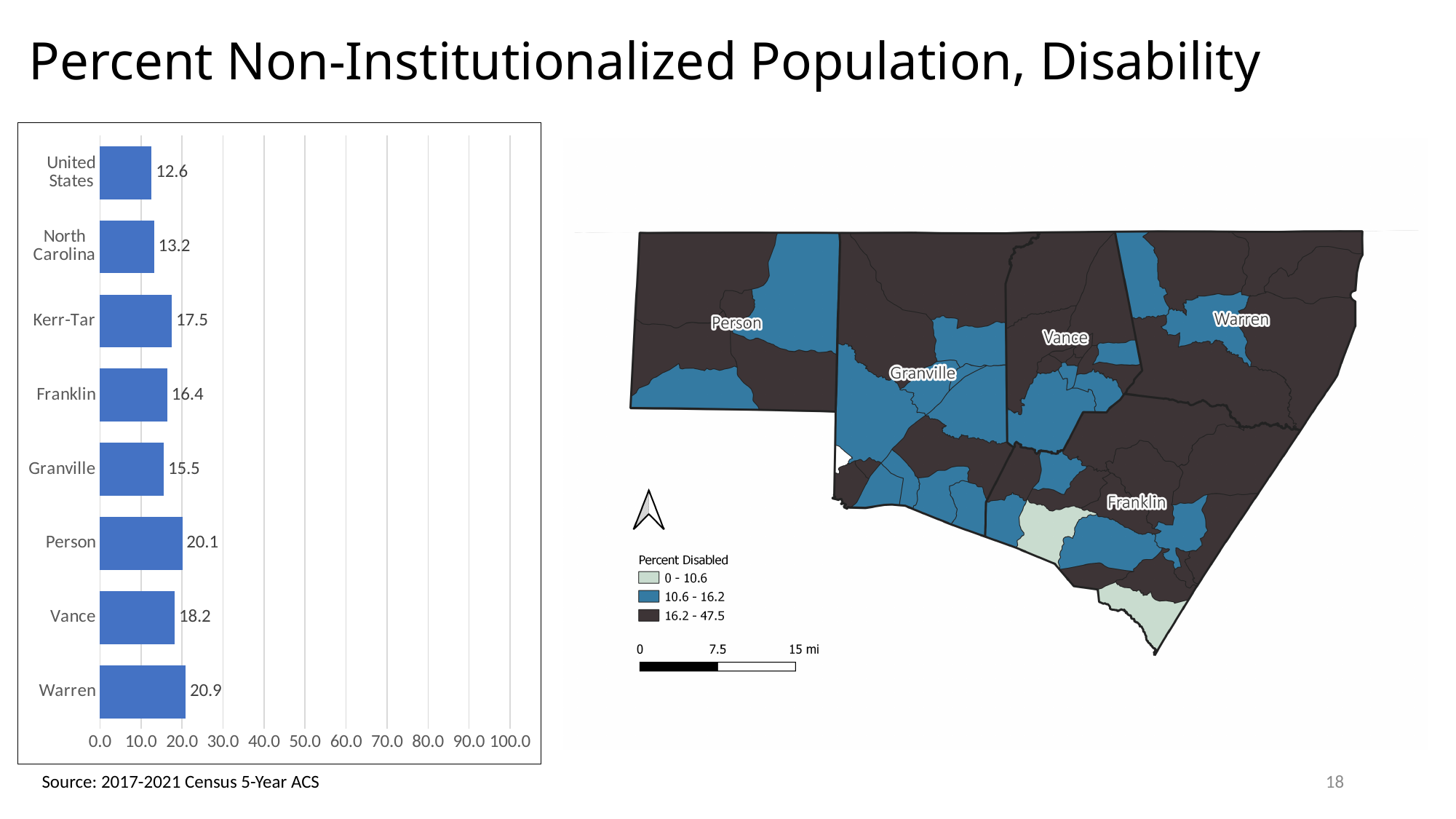
What is the value for Warren in the bar chart? 20.9 Which has a larger value in the bar chart, Vance or Franklin? Vance Is the value for Person in the bar chart greater or less than 30.0? less What is the difference between the values for Warren and United States in the bar chart? 8.3 What is the value for North Carolina in the bar chart? 13.2 What is the difference between the values for Person and Granville in the bar chart? 4.6 Which category has the highest value in the bar chart? Warren What kind of chart is shown on the left of the slide? bar chart What is the highest value on the x axis of the bar chart? 100.0 How many categories are shown in the bar chart? 8 Which category has the lowest value in the bar chart? United States What is the value for Kerr-Tar in the bar chart? 17.5